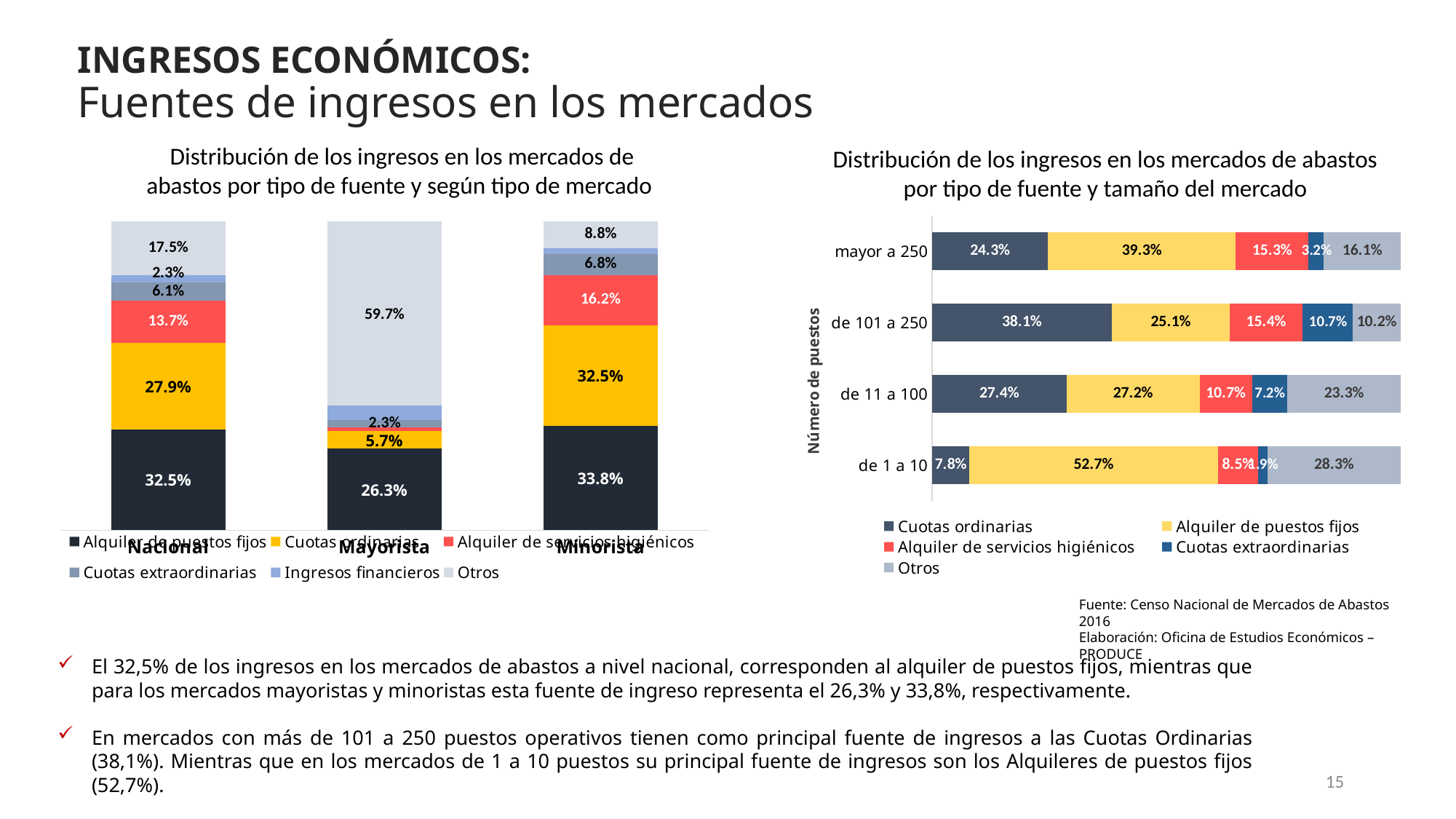
In the right chart (by tamaño del mercado), which market size category has the highest Cuotas ordinarias value? de 101 a 250 In the right chart (by tamaño del mercado), what is the value for Cuotas ordinarias in the 'de 101 a 250' bar? 38.1% In the left chart (by tipo de mercado), how many series does the legend list? 6 In the right chart (by tamaño del mercado), is the Cuotas extraordinarias value larger for 'de 101 a 250' or for 'mayor a 250'? de 101 a 250 In the left chart (by tipo de mercado), what is the value for Cuotas ordinarias in the Minorista bar? 32.5% In the right chart (by tamaño del mercado), which market size category has the lowest Otros value? de 101 a 250 In the right chart (by tamaño del mercado), how many market size categories are shown? 4 What kind of chart is the right chart (by tamaño del mercado)? Stacked horizontal bar chart In the left chart (by tipo de mercado), what is the value for Otros in the Mayorista bar? 59.7% In the right chart (by tamaño del mercado), what is the value for Alquiler de puestos fijos in the 'de 1 a 10' bar? 52.7% In the left chart (by tipo de mercado), what is the difference between the Alquiler de puestos fijos values for Minorista and Mayorista? 7.5% In the left chart (by tipo de mercado), what is the value for Alquiler de puestos fijos in the Nacional bar? 32.5%